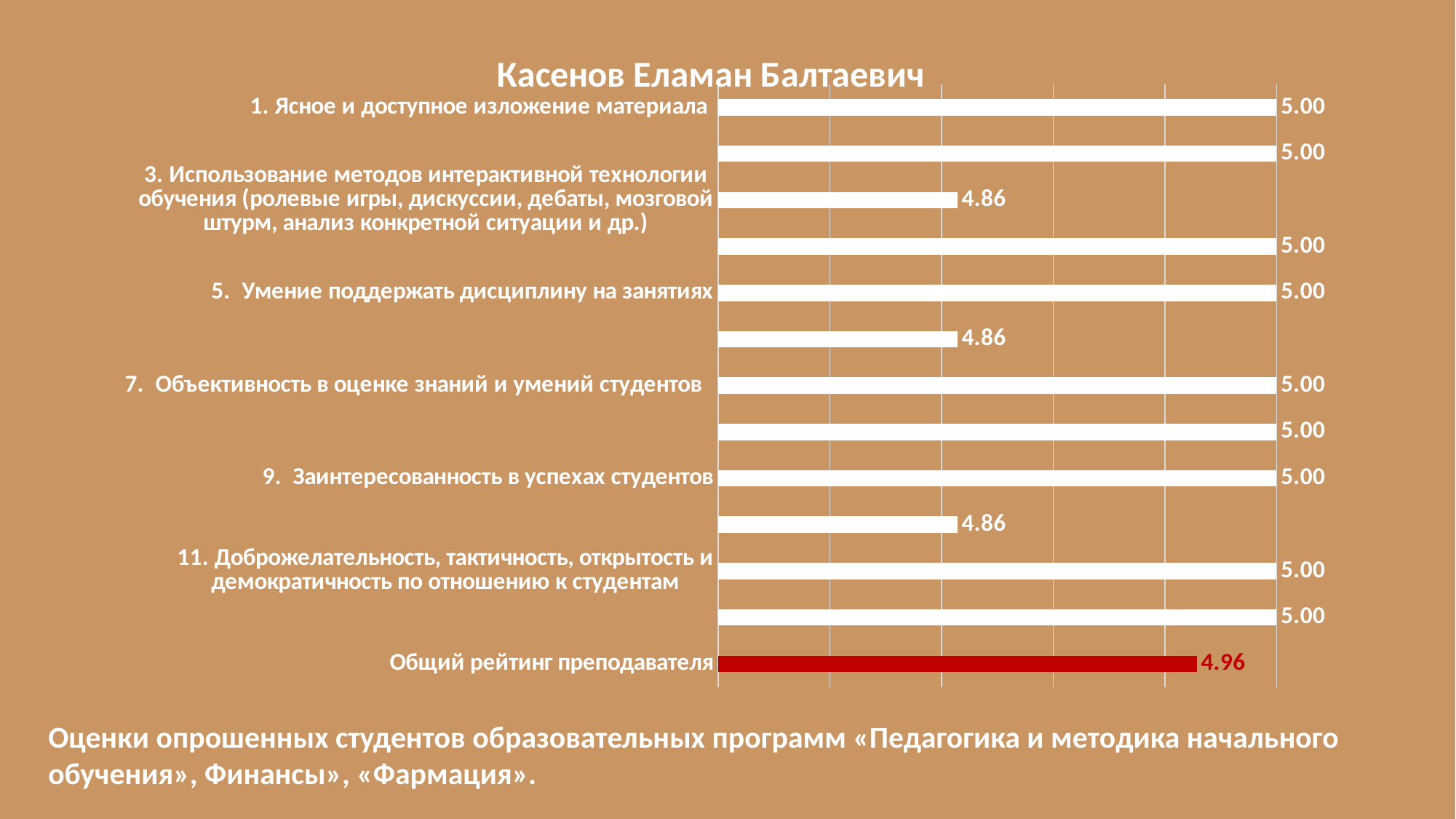
What is the value for "11. Доброжелательность, тактичность, открытость и демократичность по отношению к студентам"? 5.00 What is the value for "1. Ясное и доступное изложение материала"? 5.00 What colour is the bar for "Общий рейтинг преподавателя"? Red Which is larger: the value for "Общий рейтинг преподавателя" or the value for "3. Использование методов интерактивной технологии обучения"? Общий рейтинг преподавателя What kind of chart is shown on the slide? Bar chart What is the value for "3. Использование методов интерактивной технологии обучения"? 4.86 What is the value for "Общий рейтинг преподавателя"? 4.96 What is the lowest value shown on the chart? 4.86 What is the difference between the value for "1. Ясное и доступное изложение материала" and the value for "3. Использование методов интерактивной технологии обучения"? 0.14 What is the value for "5. Умение поддержать дисциплину на занятиях"? 5.00 What is the highest value shown on the chart? 5.00 How many bars are plotted on the chart? 13